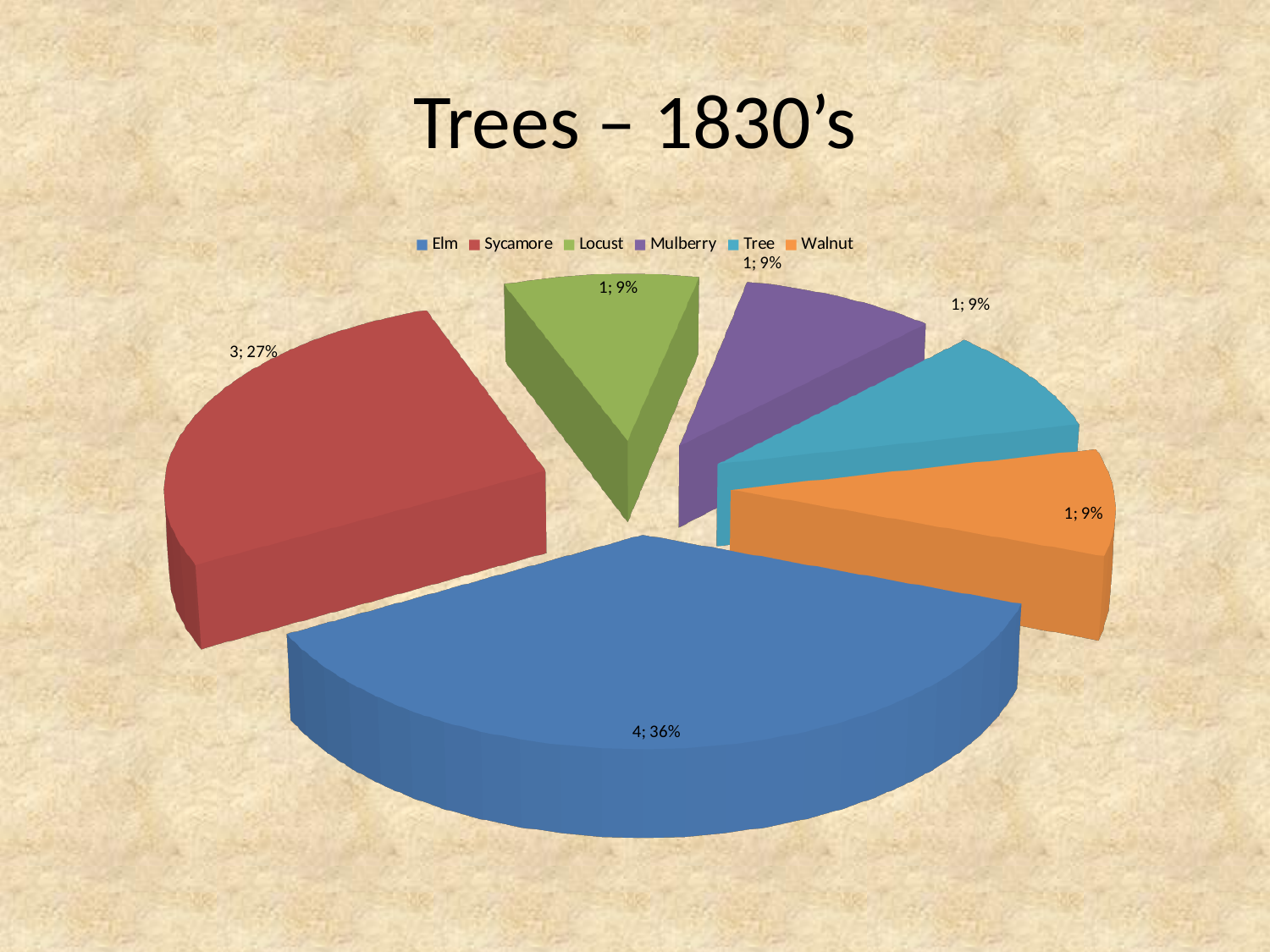
How many categories does the legend list? 6 What is the value for Elm? 4 Which is larger, the slice for Sycamore or the slice for Walnut? Sycamore What kind of chart is shown on the slide? Pie chart What is the value for Sycamore? 3 What percentage share of the pie does Sycamore have? 27% What percentage share of the pie does Locust have? 9% What percentage share of the pie does Elm have? 36% Which colour represents Walnut in the chart? Orange Which category has the largest slice? Elm What is the title of the chart? Trees – 1830's What is the difference between the values for Elm and Sycamore? 1